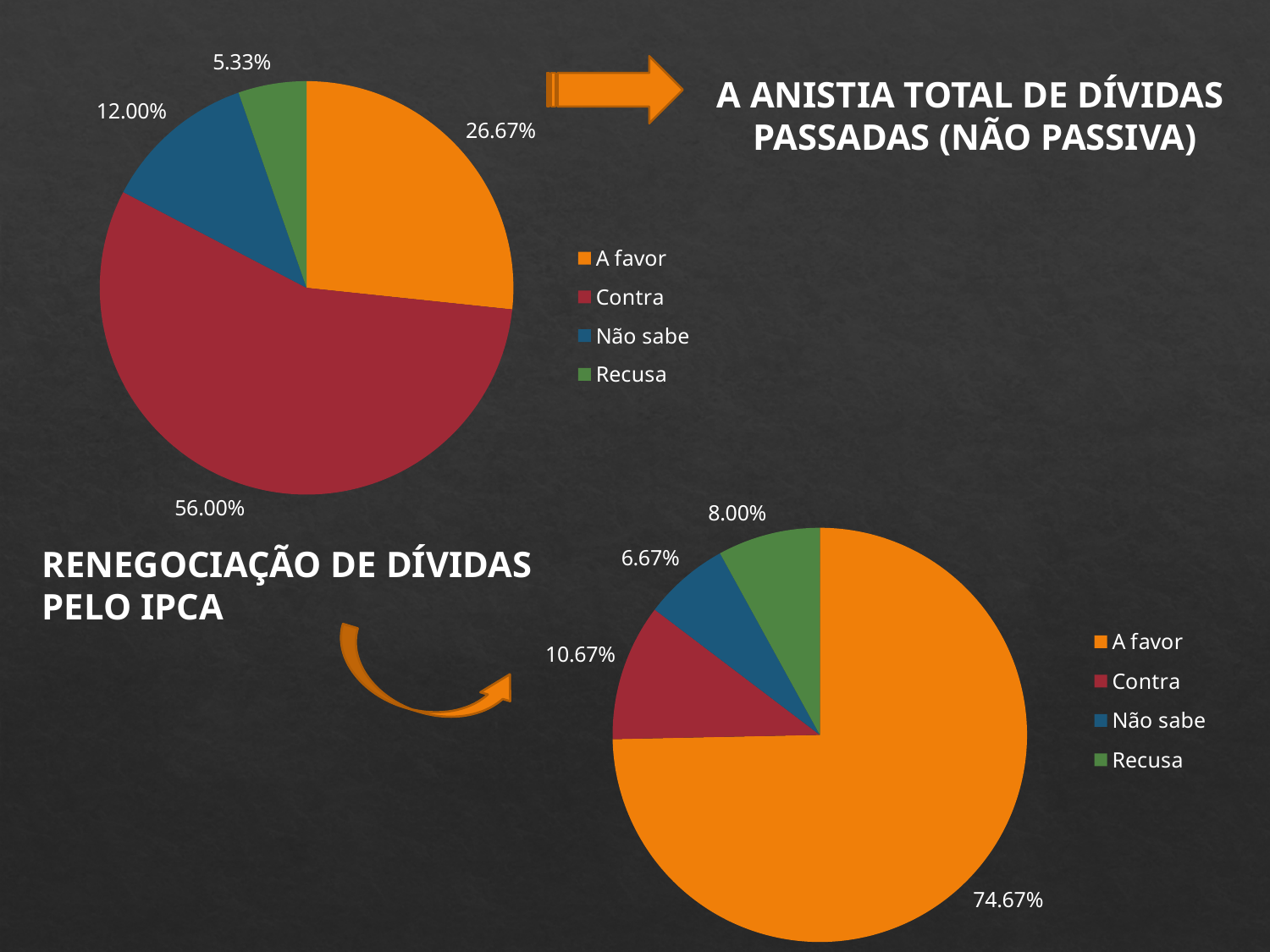
In the bottom-right pie chart (Renegociação de dívidas pelo IPCA), what share is labelled for Não sabe? 6.67% In the bottom-right pie chart (Renegociação de dívidas pelo IPCA), what share is labelled for A favor? 74.67% In the top-left pie chart (A anistia total de dívidas passadas), what share is labelled for Contra? 56.00% What type of chart is the top-left chart (A anistia total de dívidas passadas)? Pie chart In the top-left pie chart (A anistia total de dívidas passadas), what is the difference between the Contra and A favor shares? 29.33% In the top-left pie chart (A anistia total de dívidas passadas), which category has the smallest slice? Recusa In the top-left pie chart (A anistia total de dívidas passadas), what colour is the Não sabe slice? Blue In the bottom-right pie chart (Renegociação de dívidas pelo IPCA), which is larger, Contra or Recusa? Contra In the top-left pie chart (A anistia total de dívidas passadas), what share is labelled for A favor? 26.67% In the top-left pie chart (A anistia total de dívidas passadas), which category has the largest slice? Contra In the bottom-right pie chart (Renegociação de dívidas pelo IPCA), which category has the smallest slice? Não sabe How many categories does the legend of the bottom-right pie chart (Renegociação de dívidas pelo IPCA) list? 4